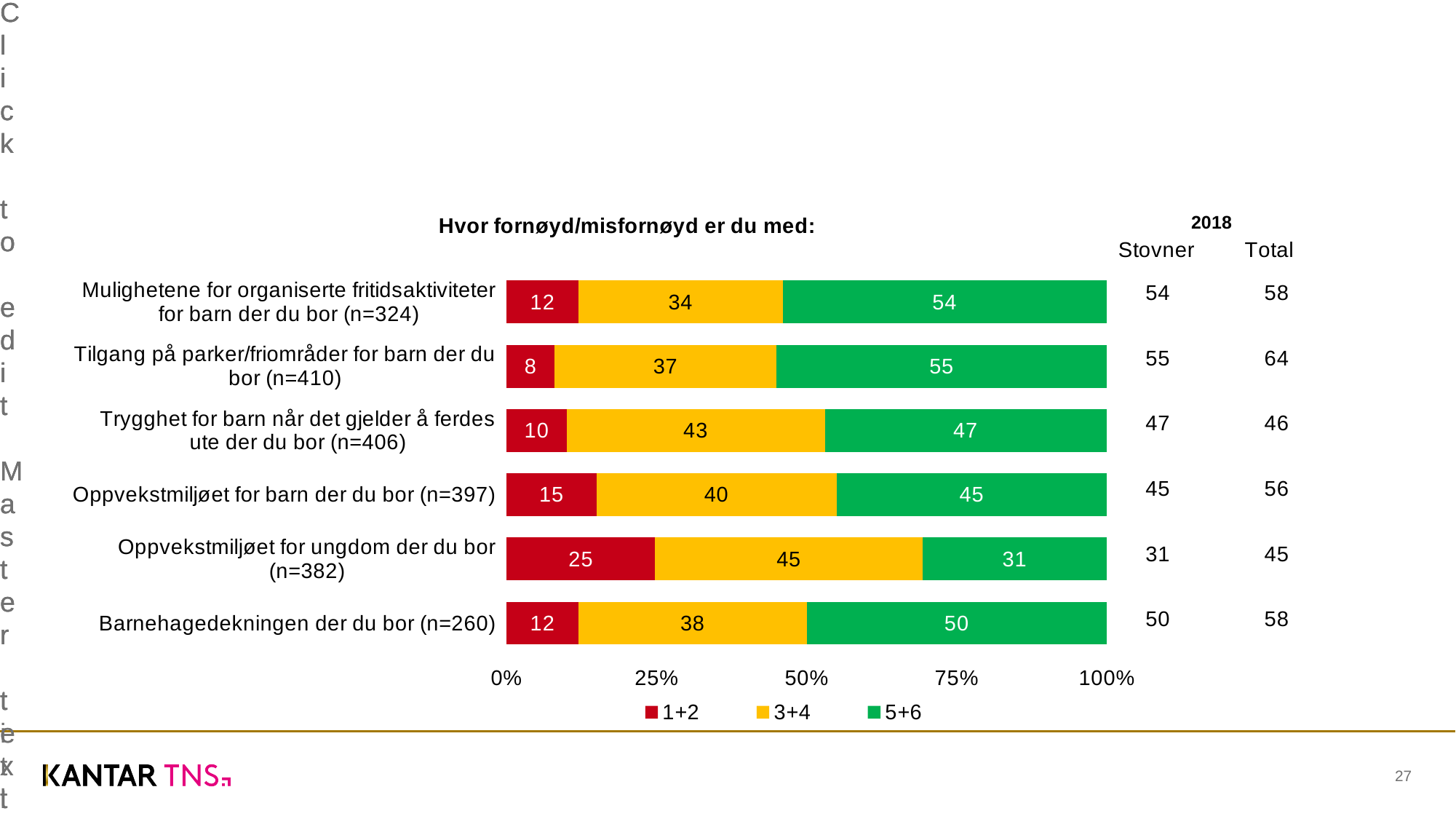
How many series does the legend list? 3 How many categories are shown in the chart? 6 Which category has the highest value for the 5+6 series? Tilgang på parker/friområder for barn der du bor (n=410) What is the value of the 1+2 series for "Oppvekstmiljøet for ungdom der du bor (n=382)"? 25 Which is larger: the 3+4 value for "Oppvekstmiljøet for barn der du bor (n=397)" or the 3+4 value for "Mulighetene for organiserte fritidsaktiviteter for barn der du bor (n=324)"? Oppvekstmiljøet for barn der du bor (n=397) What is the total of the stacked bar for "Mulighetene for organiserte fritidsaktiviteter for barn der du bor (n=324)"? 100 What is the value of the 3+4 series for "Trygghet for barn når det gjelder å ferdes ute der du bor (n=406)"? 43 What is the value of the 5+6 series for "Tilgang på parker/friområder for barn der du bor (n=410)"? 55 Which category has the lowest value for the 5+6 series? Oppvekstmiljøet for ungdom der du bor (n=382) What kind of chart is shown on the slide? Stacked bar chart Which category has the lowest value for the 1+2 series? Tilgang på parker/friområder for barn der du bor (n=410) What is the difference between the 5+6 values for "Barnehagedekningen der du bor (n=260)" and "Oppvekstmiljøet for ungdom der du bor (n=382)"? 19